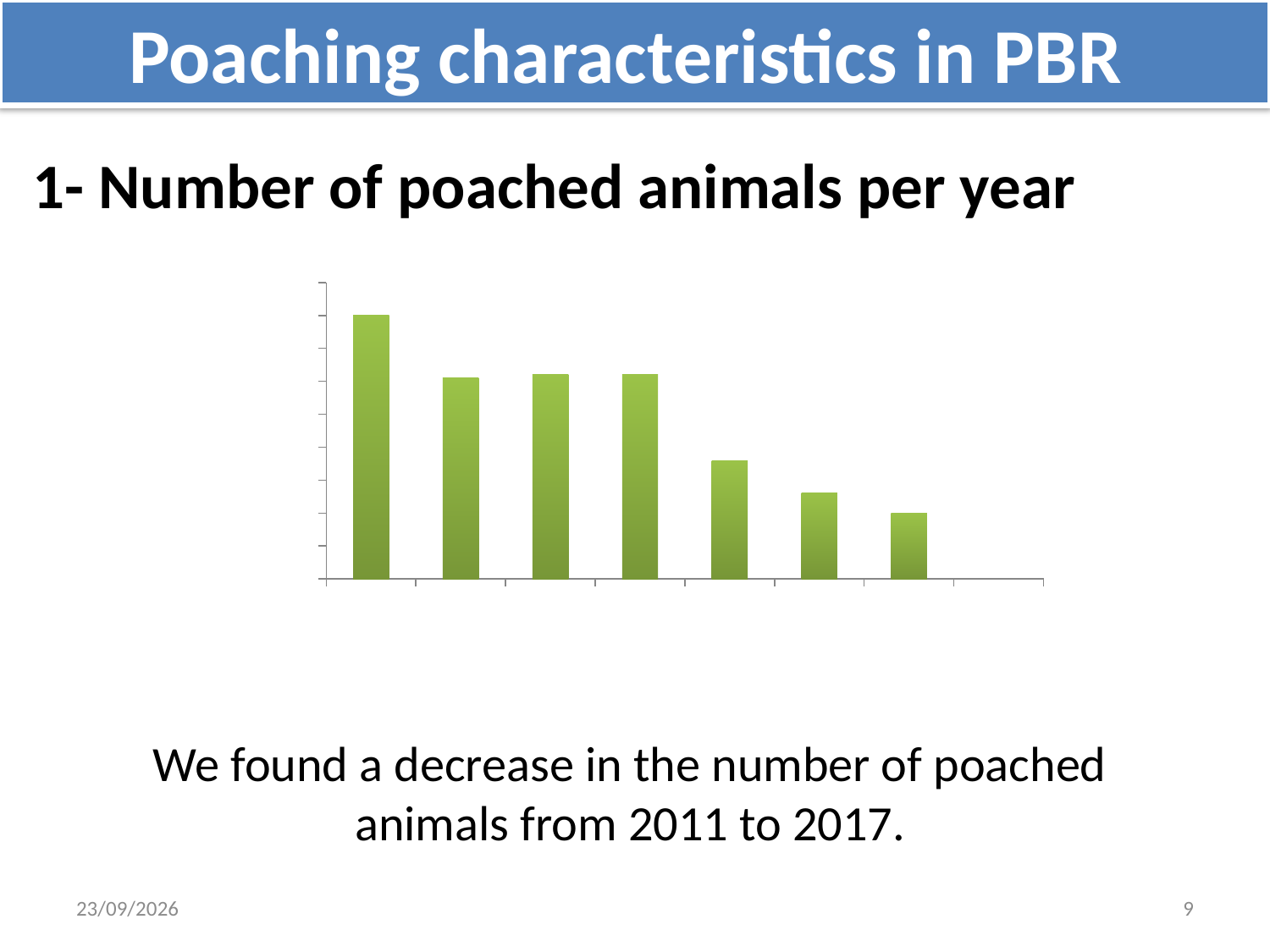
Which bar in the chart is the shortest? the last (rightmost) bar Does the chart display a legend? No What colour are the bars in the chart? green Which bar in the chart is the tallest? the first (leftmost) bar Which is taller, the leftmost bar or the rightmost bar? the leftmost bar Which is taller, the fifth bar or the second bar? the second bar Do the bar values generally rise or fall from left to right across the chart? fall What kind of chart is shown on the slide? bar chart How many bars are plotted in the chart? 7